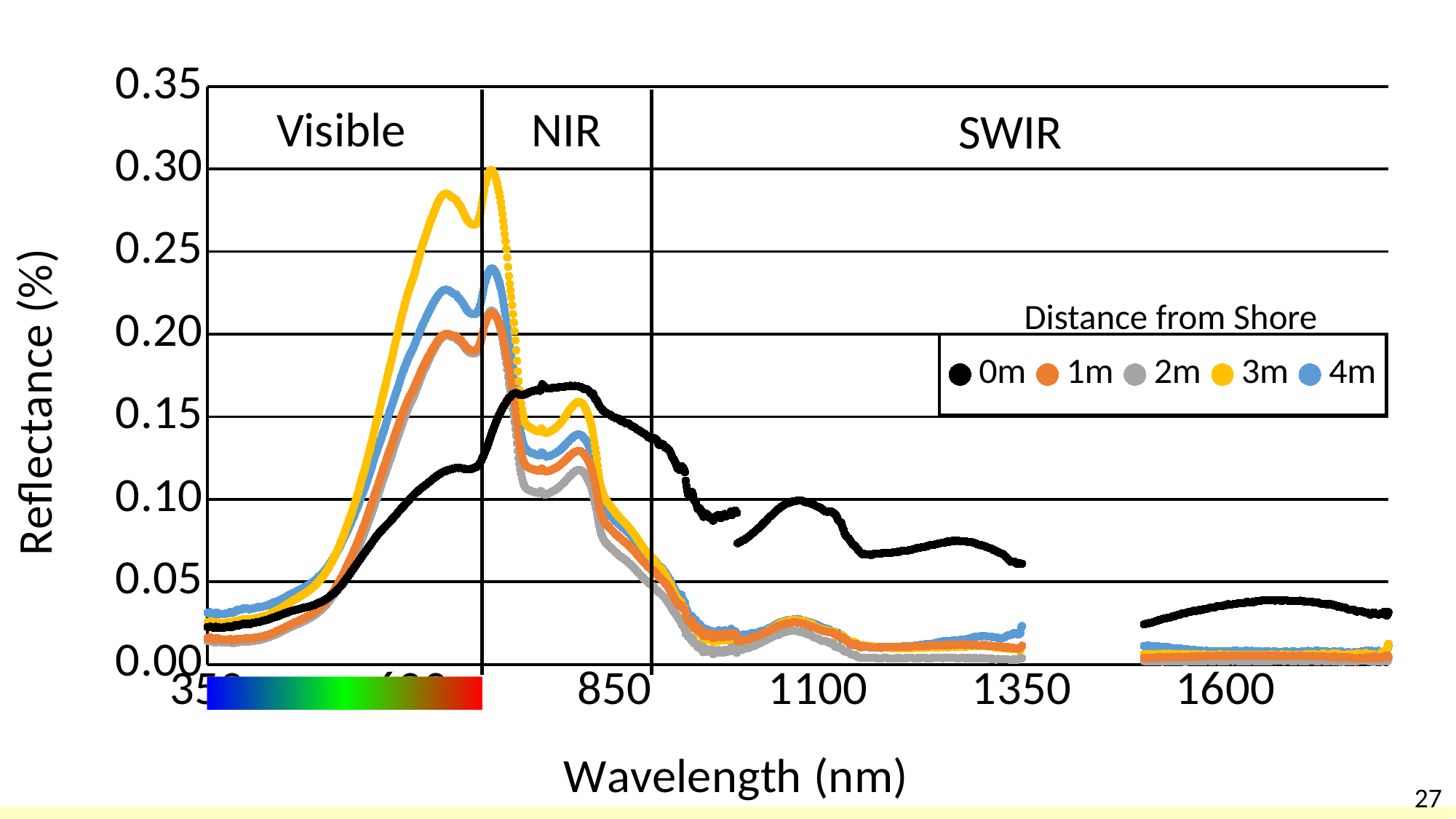
What kind of chart is shown on the slide? line chart Is the peak value for the 4m series greater or less than 0.20? greater Is the peak value for the 3m series greater or less than 0.25? greater Around 1600 nm, which series has the larger reflectance, 0m or 2m? 0m Is the value for the 0m series around 1600 nm greater or less than 0.05? less How many series does the legend list? 5 Do the reflectance values for the 3m series rise or fall between 850 nm and 1100 nm? fall What is the title of the legend? Distance from Shore Which series reaches the highest peak reflectance? 3m Which series has the highest reflectance in the SWIR region around 1600 nm? 0m What is the label of the y axis? Reflectance (%)